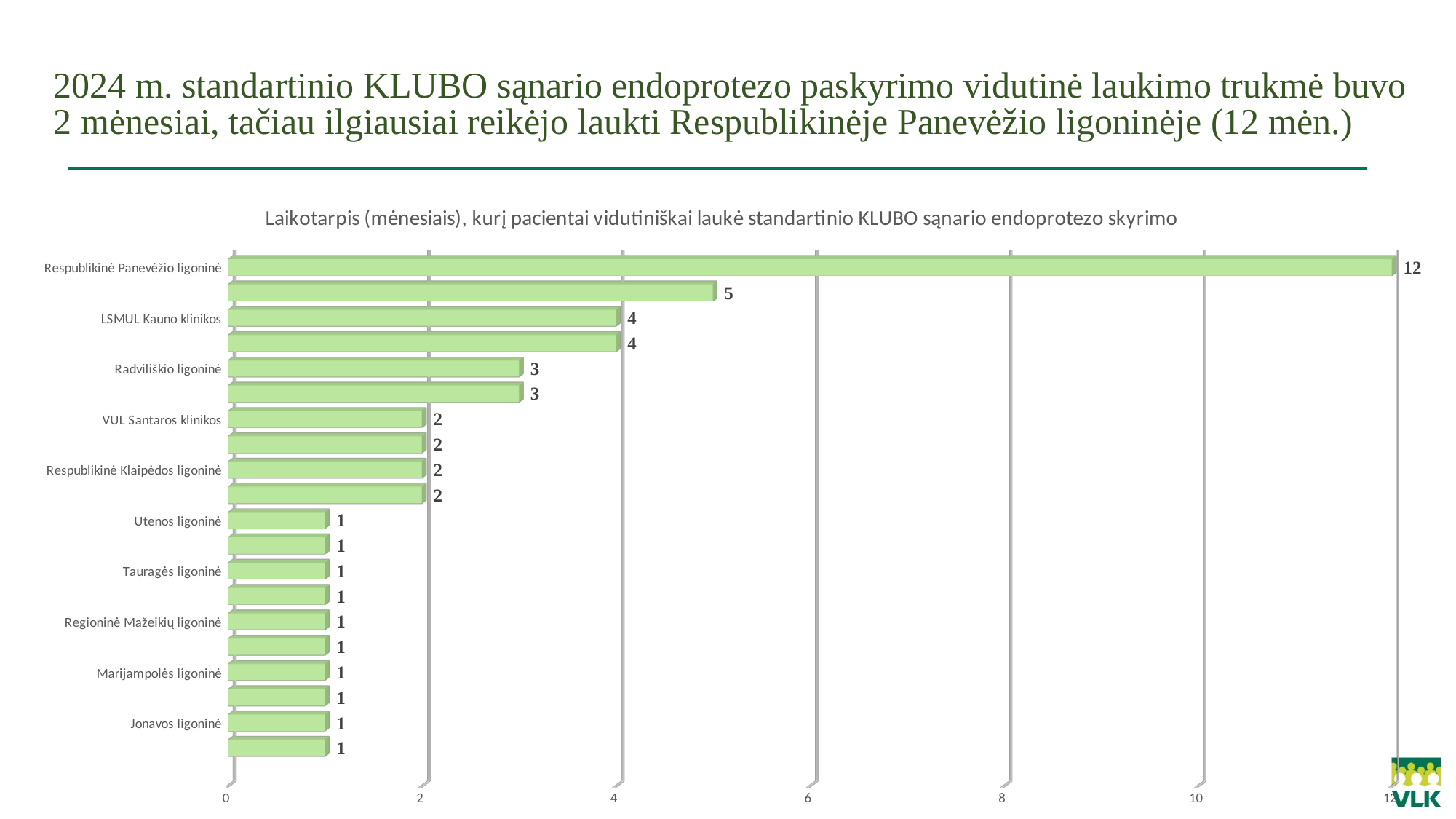
What is the value for Radviliškio ligoninė? 3 Which hospital has the highest value in the chart? Respublikinė Panevėžio ligoninė What is the difference between the values for Respublikinė Panevėžio ligoninė and LSMUL Kauno klinikos? 8 What is the value for Utenos ligoninė? 1 How many bars are plotted in the chart? 20 What is the title of the chart? Laikotarpis (mėnesiais), kurį pacientai vidutiniškai laukė standartinio KLUBO sąnario endoprotezo skyrimo What is the value for Respublikinė Klaipėdos ligoninė? 2 What kind of chart is shown on the slide? Bar chart What is the value for LSMUL Kauno klinikos? 4 What is the value for VUL Santaros klinikos? 2 What is the value for Respublikinė Panevėžio ligoninė? 12 Which has a larger value, Radviliškio ligoninė or VUL Santaros klinikos? Radviliškio ligoninė